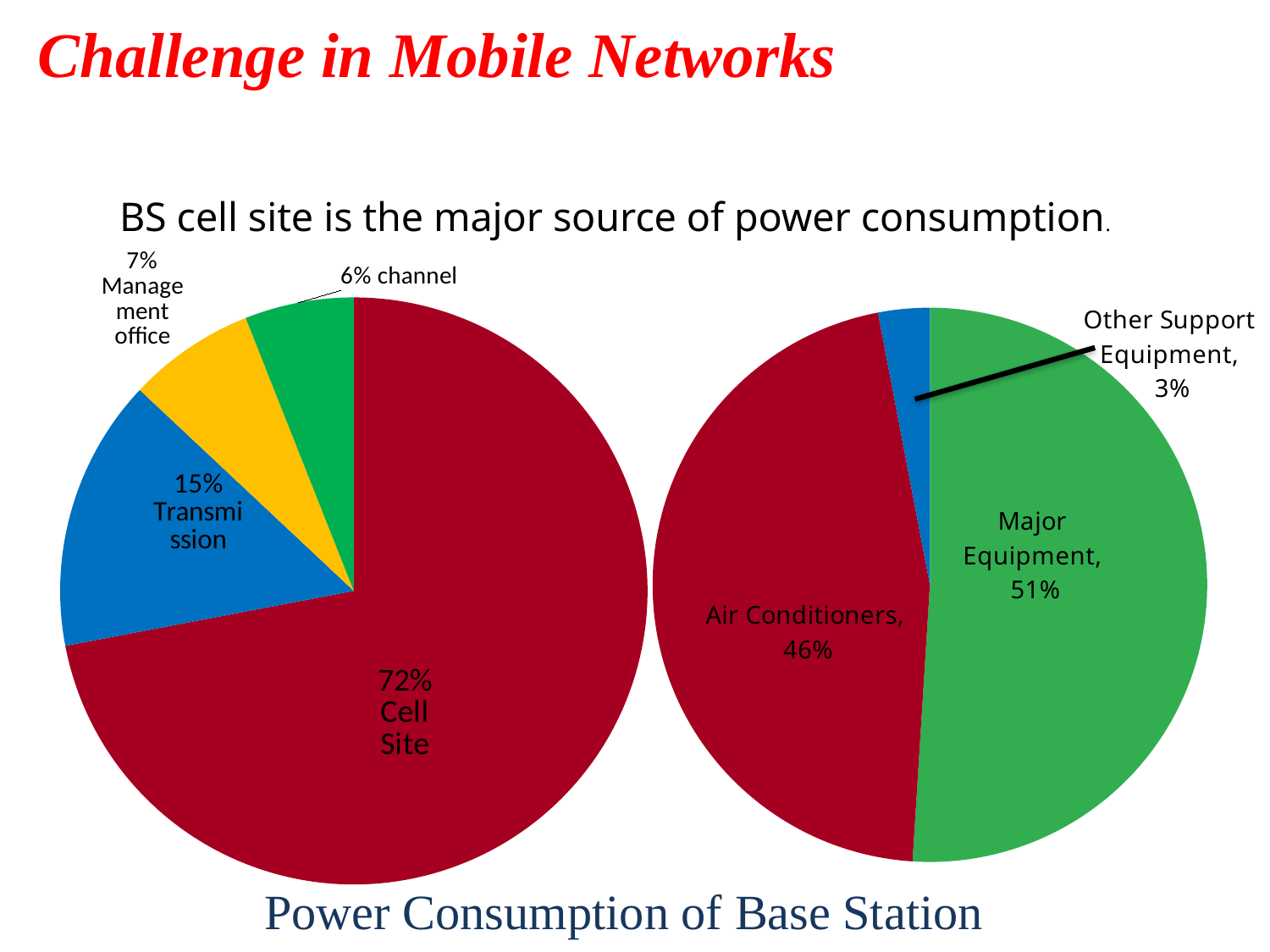
In the left pie chart, which category has the smallest share? channel In the right pie chart, which is larger, Major Equipment or Air Conditioners? Major Equipment What type of chart is shown on the right side of the slide? Pie chart In the left pie chart, which category has the largest share? Cell Site In the right pie chart, what share do Air Conditioners account for? 46% In the right pie chart, which category has the largest share? Major Equipment In the left pie chart, how many slices are there? 4 In the left pie chart, what share does Cell Site account for? 72% In the left pie chart, what share does the Management office account for? 7% In the left pie chart, what share does Transmission account for? 15% In the right pie chart, what share does Other Support Equipment account for? 3% In the left pie chart, what is the difference between the Cell Site share and the Transmission share? 57%